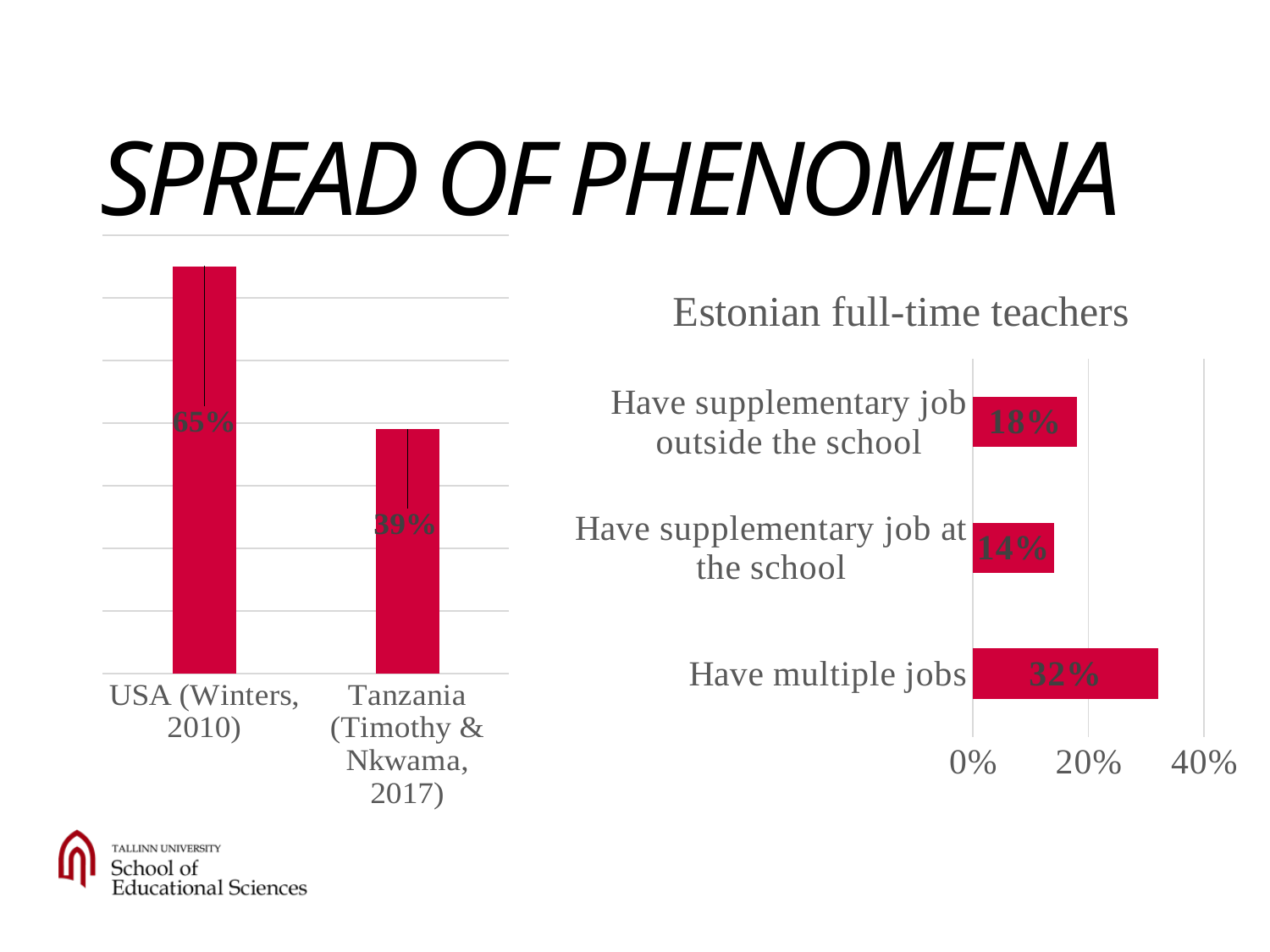
In the 'Estonian full-time teachers' chart, which category has the lowest value? Have supplementary job at the school In the 'Estonian full-time teachers' chart, what is the value for 'Have multiple jobs'? 32% In the 'Estonian full-time teachers' chart, what is the value for 'Have supplementary job at the school'? 14% In the left chart, how many categories are shown? 2 What kind of chart is the 'Estonian full-time teachers' chart? Bar chart In the 'Estonian full-time teachers' chart, what is the value for 'Have supplementary job outside the school'? 18% In the left chart, what is the value for Tanzania (Timothy & Nkwama, 2017)? 39% In the 'Estonian full-time teachers' chart, what is the difference between 'Have multiple jobs' and 'Have supplementary job outside the school'? 14% In the left chart, what is the value for USA (Winters, 2010)? 65% In the 'Estonian full-time teachers' chart, which category has the highest value? Have multiple jobs In the left chart, which category has the higher value? USA (Winters, 2010) In the left chart, what is the difference between the USA and Tanzania values? 26%